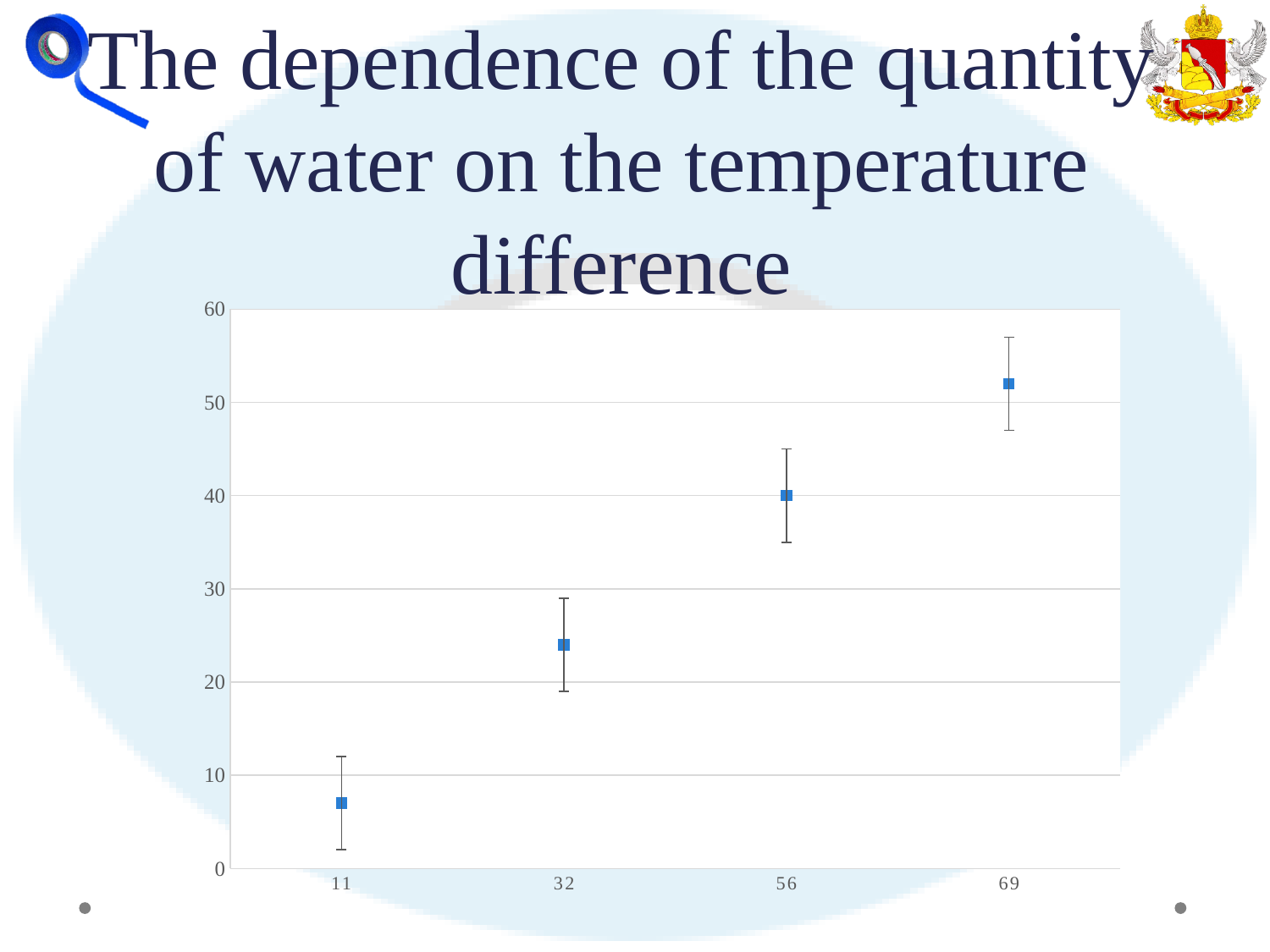
How many data points are plotted on the chart? 4 Which x-axis category has the highest plotted value? 69 Is the value for x = 56 greater or less than 50? less Which x-axis category has the lowest plotted value? 11 Do the plotted values rise or fall as the x-axis values increase from 11 to 69? rise What is the highest value shown on the y-axis of the chart? 60 Is the value for x = 11 greater or less than 10? less Is the value for x = 69 greater or less than 50? greater What is the title of the slide containing the chart? The dependence of the quantity of water on the temperature difference Which has the larger plotted value, x = 32 or x = 56? 56 What kind of chart is shown on the slide? scatter chart